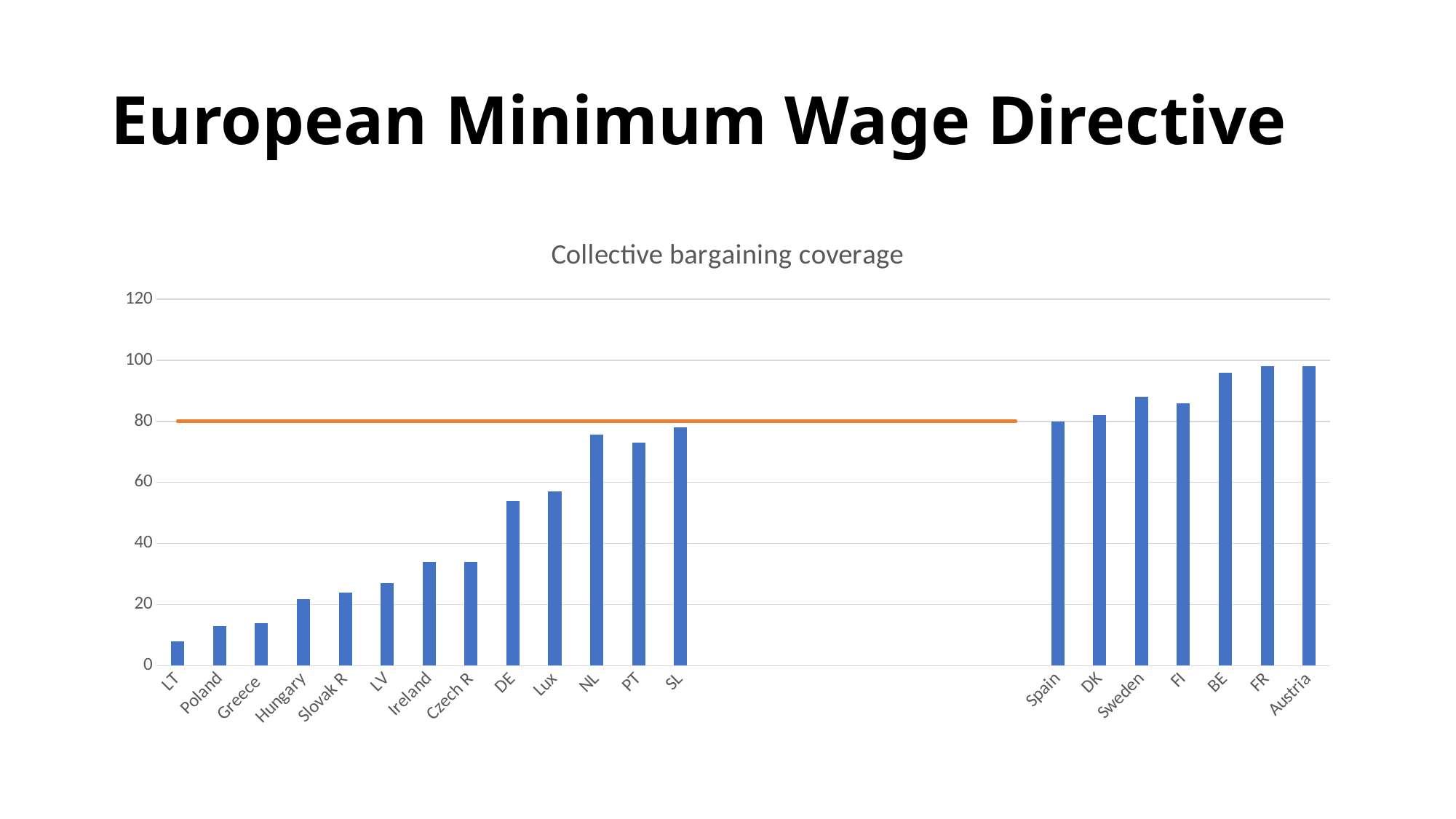
Is the value for NL greater or less than 80? less Is the value for LT greater or less than 20? less Is the value for Ireland greater or less than 40? less Which country has the lowest collective bargaining coverage? LT How many countries are labelled on the x axis of the chart? 20 What is the title of the chart? Collective bargaining coverage Which has a higher collective bargaining coverage, BE or DK? BE Do the values generally rise or fall moving from left to right along the x axis? rise What kind of chart is shown on the slide? combination bar and line chart (bars with a horizontal line) At what value on the y axis is the horizontal orange line drawn? 80